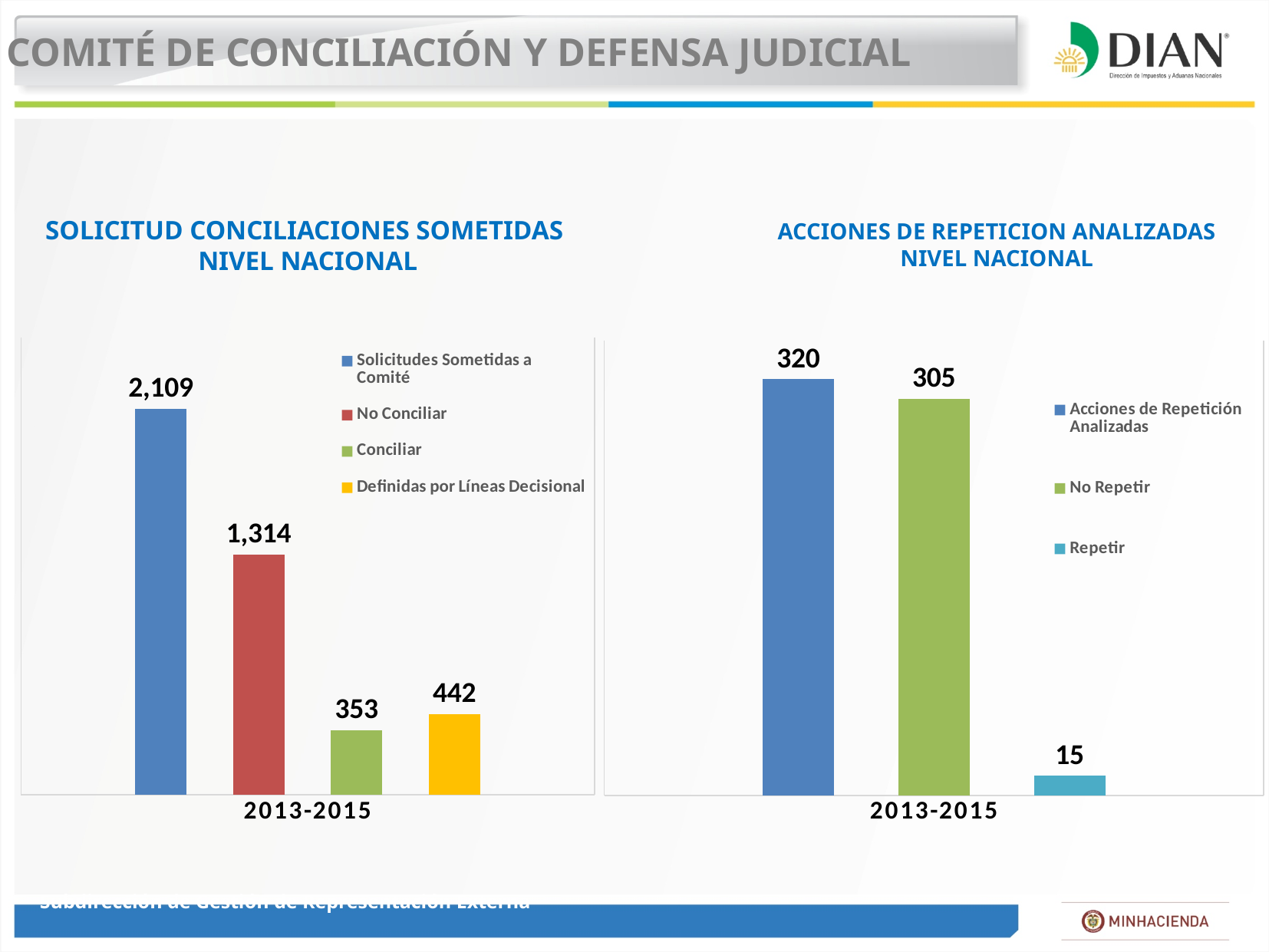
In the 'ACCIONES DE REPETICION ANALIZADAS NIVEL NACIONAL' chart, what is the value for 'No Repetir'? 305 In the 'SOLICITUD CONCILIACIONES SOMETIDAS NIVEL NACIONAL' chart, what is the value for 'Definidas por Líneas Decisional'? 442 In the 'ACCIONES DE REPETICION ANALIZADAS NIVEL NACIONAL' chart, which series has the highest value? Acciones de Repetición Analizadas In the 'ACCIONES DE REPETICION ANALIZADAS NIVEL NACIONAL' chart, what is the difference between 'Acciones de Repetición Analizadas' and 'No Repetir'? 15 In the 'ACCIONES DE REPETICION ANALIZADAS NIVEL NACIONAL' chart, what is the value for 'Repetir'? 15 In the 'SOLICITUD CONCILIACIONES SOMETIDAS NIVEL NACIONAL' chart, what is the value for 'No Conciliar'? 1,314 In the 'SOLICITUD CONCILIACIONES SOMETIDAS NIVEL NACIONAL' chart, what is the value for 'Solicitudes Sometidas a Comité'? 2,109 In the 'SOLICITUD CONCILIACIONES SOMETIDAS NIVEL NACIONAL' chart, how many series does the legend list? 4 In the 'SOLICITUD CONCILIACIONES SOMETIDAS NIVEL NACIONAL' chart, what is the difference between 'No Conciliar' and 'Conciliar'? 961 In the 'SOLICITUD CONCILIACIONES SOMETIDAS NIVEL NACIONAL' chart, which series has the lowest value? Conciliar What kind of chart is the 'ACCIONES DE REPETICION ANALIZADAS NIVEL NACIONAL' chart? Bar chart In the 'ACCIONES DE REPETICION ANALIZADAS NIVEL NACIONAL' chart, which is larger, 'No Repetir' or 'Repetir'? No Repetir